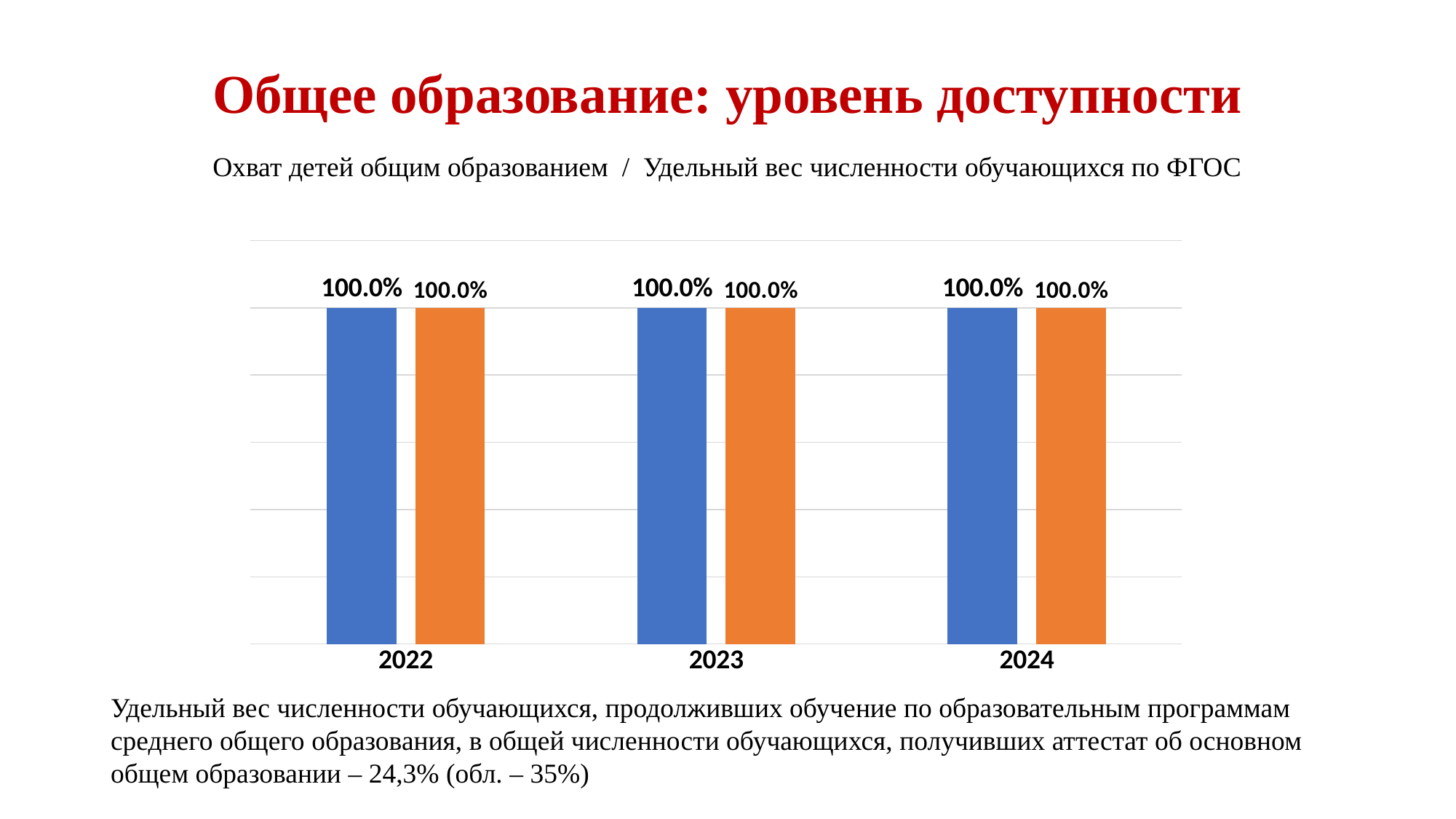
Which years are shown as categories on the x axis? 2022, 2023, 2024 What is the difference between the blue bar and the orange bar for 2023? 0.0% What is the value of the blue bar for 2022? 100.0% How many years are shown on the x axis of the chart? 3 What is the value of the orange bar for 2023? 100.0% What is the value of the orange bar for 2022? 100.0% Do the values of the blue bars rise, fall, or stay the same from 2022 to 2024? stay the same What is the value of the blue bar for 2024? 100.0% What kind of chart is shown on the slide? bar chart What is the title of the slide containing the chart? Общее образование: уровень доступности Is the blue bar for 2024 larger, smaller, or equal to the orange bar for 2024? equal How many bars are shown for each year in the chart? 2